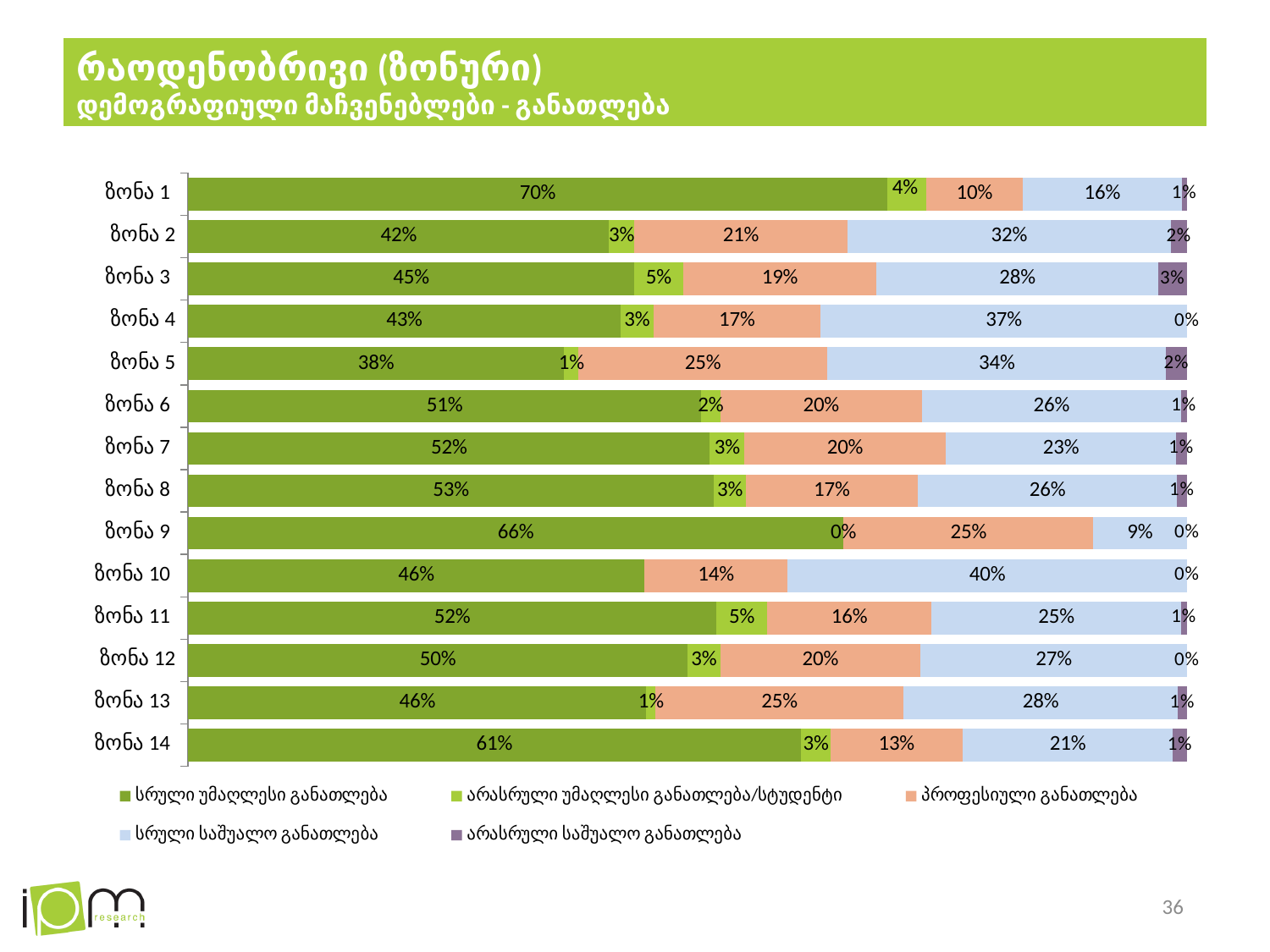
How many series does the legend list? 5 What is the value of არასრული საშუალო განათლება for ზონა 3? 3% What is the difference between the სრული უმაღლესი განათლება values for ზონა 1 and ზონა 2? 28% Which zone has the highest value for სრული უმაღლესი განათლება? ზონა 1 Which legend entry is shown in orange? პროფესიული განათლება How many zones (categories) are shown on the chart? 14 What type of chart is shown on the slide? stacked bar chart What is the value of სრული საშუალო განათლება for ზონა 10? 40% What is the value of სრული უმაღლესი განათლება for ზონა 1? 70% What is the value of პროფესიული განათლება for ზონა 9? 25% Which is larger: the სრული საშუალო განათლება value for ზონა 4 or for ზონა 5? ზონა 4 Which zone has the lowest value for სრული უმაღლესი განათლება? ზონა 5